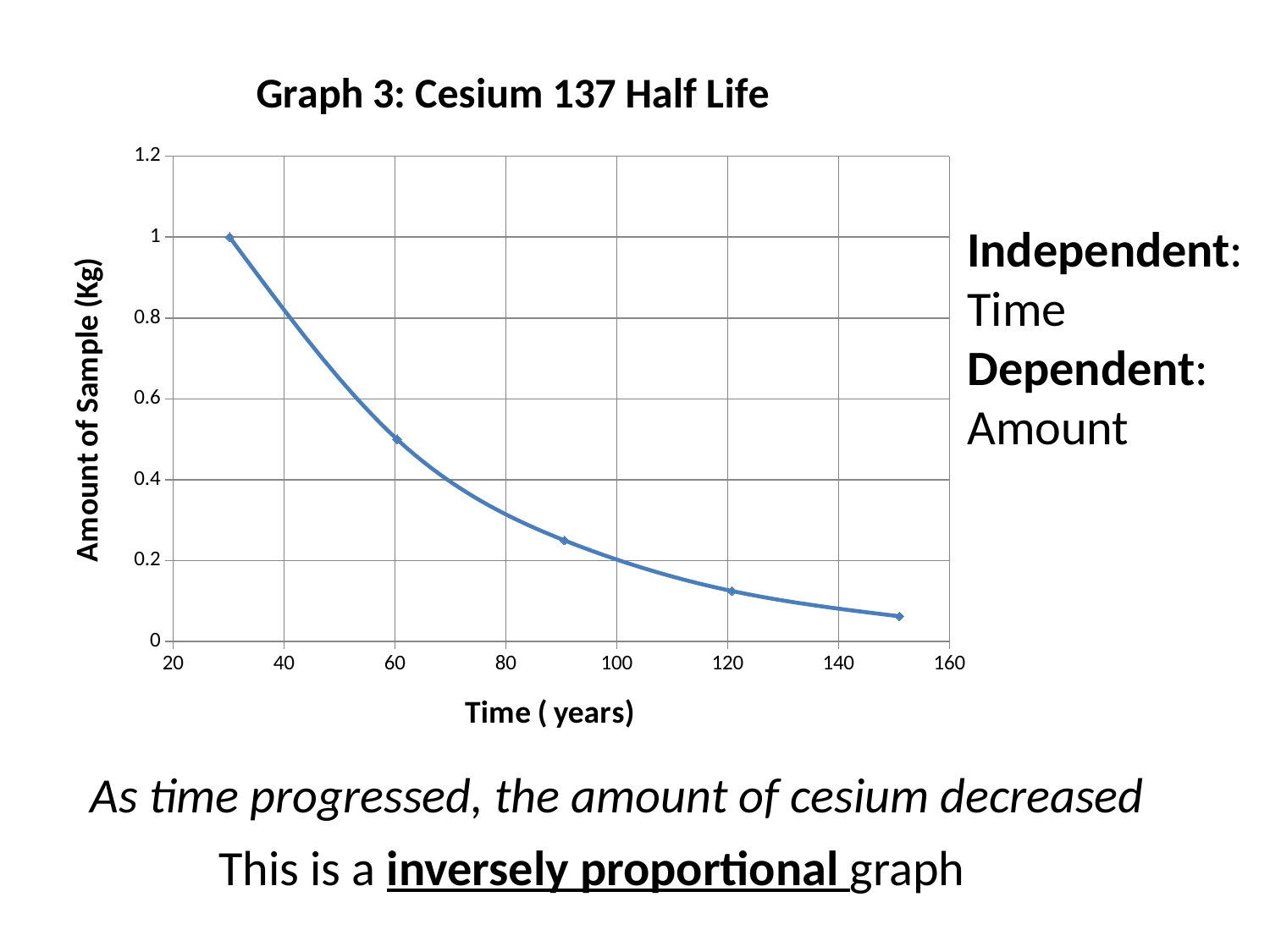
What kind of chart is shown on the slide? line chart How many data points are plotted on the chart? 5 What is the label of the y axis? Amount of Sample (Kg) What is the title of the chart? Graph 3: Cesium 137 Half Life Is the amount of sample at 60 years greater or less than 0.4? greater Do the plotted values rise or fall as time increases along the x axis? fall What is the highest amount of sample plotted on the chart? 1 Is the amount of sample at 90 years greater or less than 0.4? less Is the amount of sample at 150 years greater or less than 0.2? less Which plotted point has the highest amount of sample, the first one (around 30 years) or the last one (around 150 years)? the first one (around 30 years)